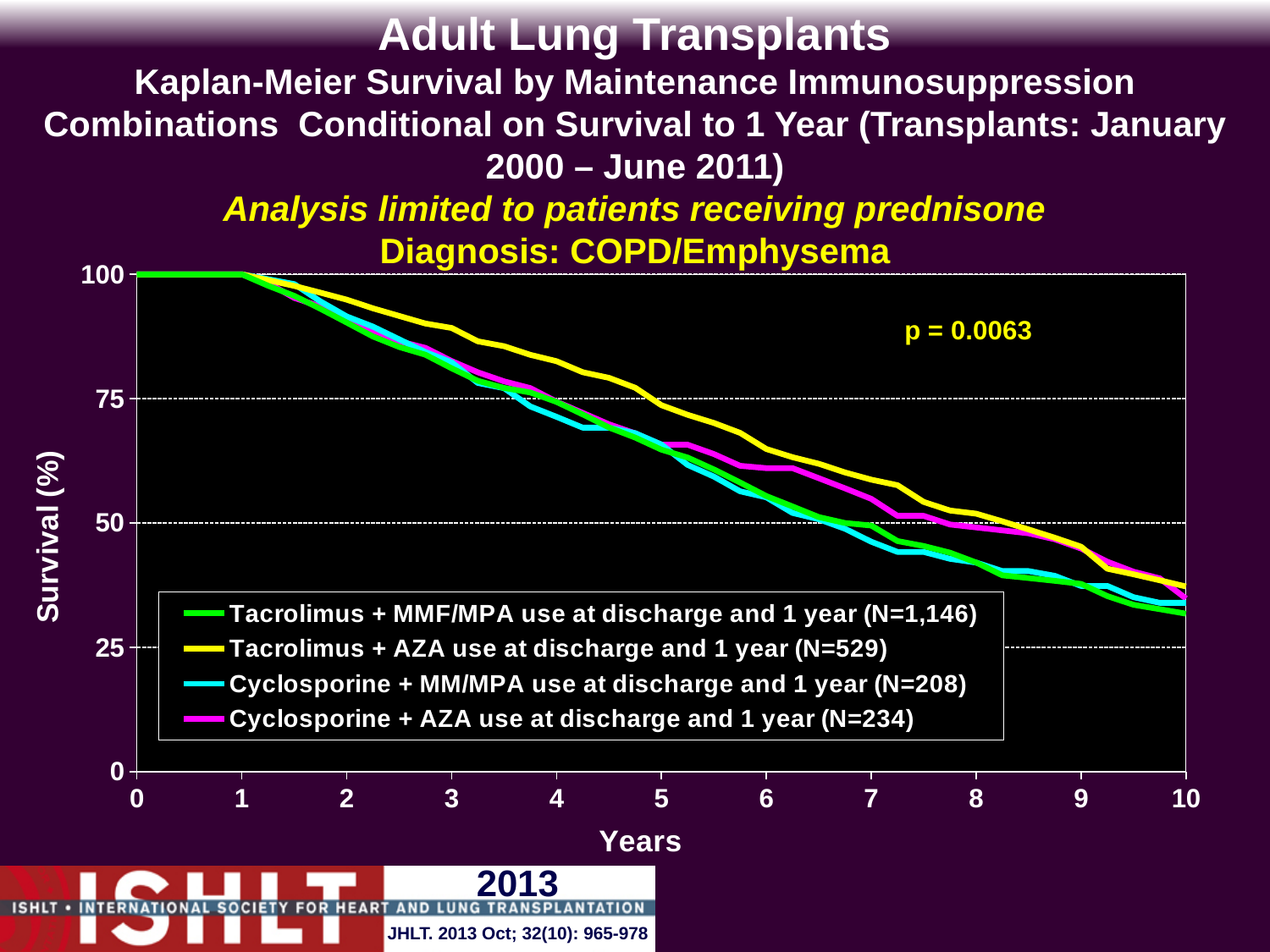
Is the survival for Tacrolimus + AZA use at discharge and 1 year at year 7 greater or less than 50? greater Which series has the highest survival at year 5? Tacrolimus + AZA use at discharge and 1 year (N=529) What is the N for the Tacrolimus + MMF/MPA use at discharge and 1 year series? N=1,146 How many series does the legend list? 4 What is the p-value shown on the chart? p = 0.0063 Is the survival for Tacrolimus + MMF/MPA use at discharge and 1 year at year 5 greater or less than 75? less At year 6, which has higher survival: Tacrolimus + AZA use at discharge and 1 year or Cyclosporine + MM/MPA use at discharge and 1 year? Tacrolimus + AZA use at discharge and 1 year Is the survival for Tacrolimus + MMF/MPA use at discharge and 1 year at year 10 greater or less than 25? greater What kind of chart is shown on the slide? line chart What is the survival (%) for all four series at year 1? 100 Do the survival curves rise or fall as years increase? fall